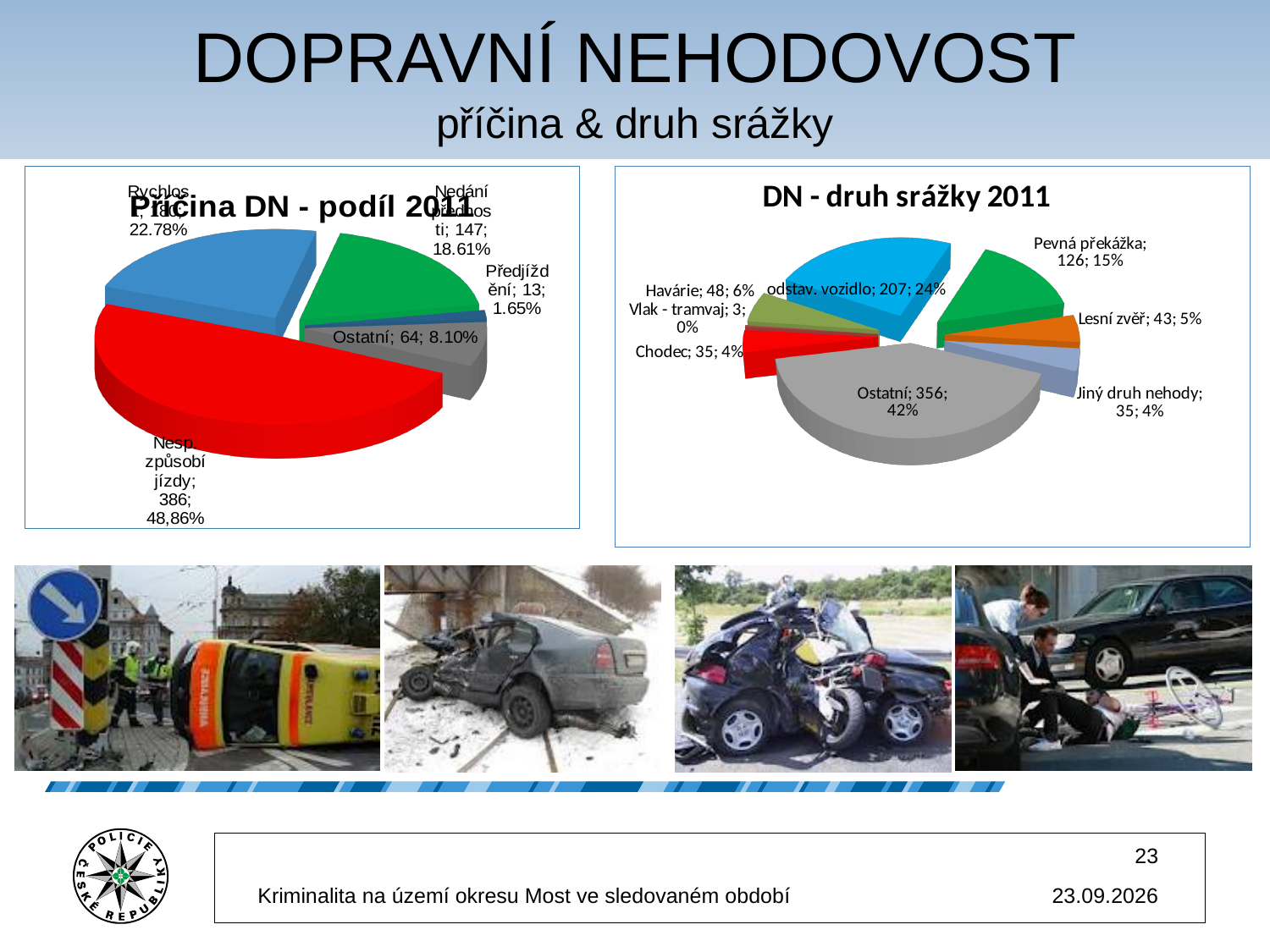
In the chart 'DN - druh srážky 2011', which is larger: 'Pevná překážka' or 'Chodec'? Pevná překážka In the chart 'DN - druh srážky 2011', how many slices does the pie have? 8 In the chart 'DN - druh srážky 2011', which category has the largest slice? Ostatní In the chart 'Příčina DN - podíl 2011', what share of the pie does 'Ostatní' represent? 8.10% In the chart 'Příčina DN - podíl 2011', which category has the smallest slice? Předjíždění In the chart 'Příčina DN - podíl 2011', what is the value for 'Nesp. způsobí jízdy'? 386 What type of chart is used on the left side of the slide? Pie chart In the chart 'DN - druh srážky 2011', what share of the pie does 'odstav. vozidlo' represent? 24% In the chart 'DN - druh srážky 2011', which category has the smallest slice? Vlak - tramvaj In the chart 'DN - druh srážky 2011', how many accidents are attributed to 'Ostatní'? 356 In the chart 'DN - druh srážky 2011', what is the value for 'Pevná překážka'? 126 In the chart 'DN - druh srážky 2011', what is the difference between the values for 'Havárie' and 'Lesní zvěř'? 5